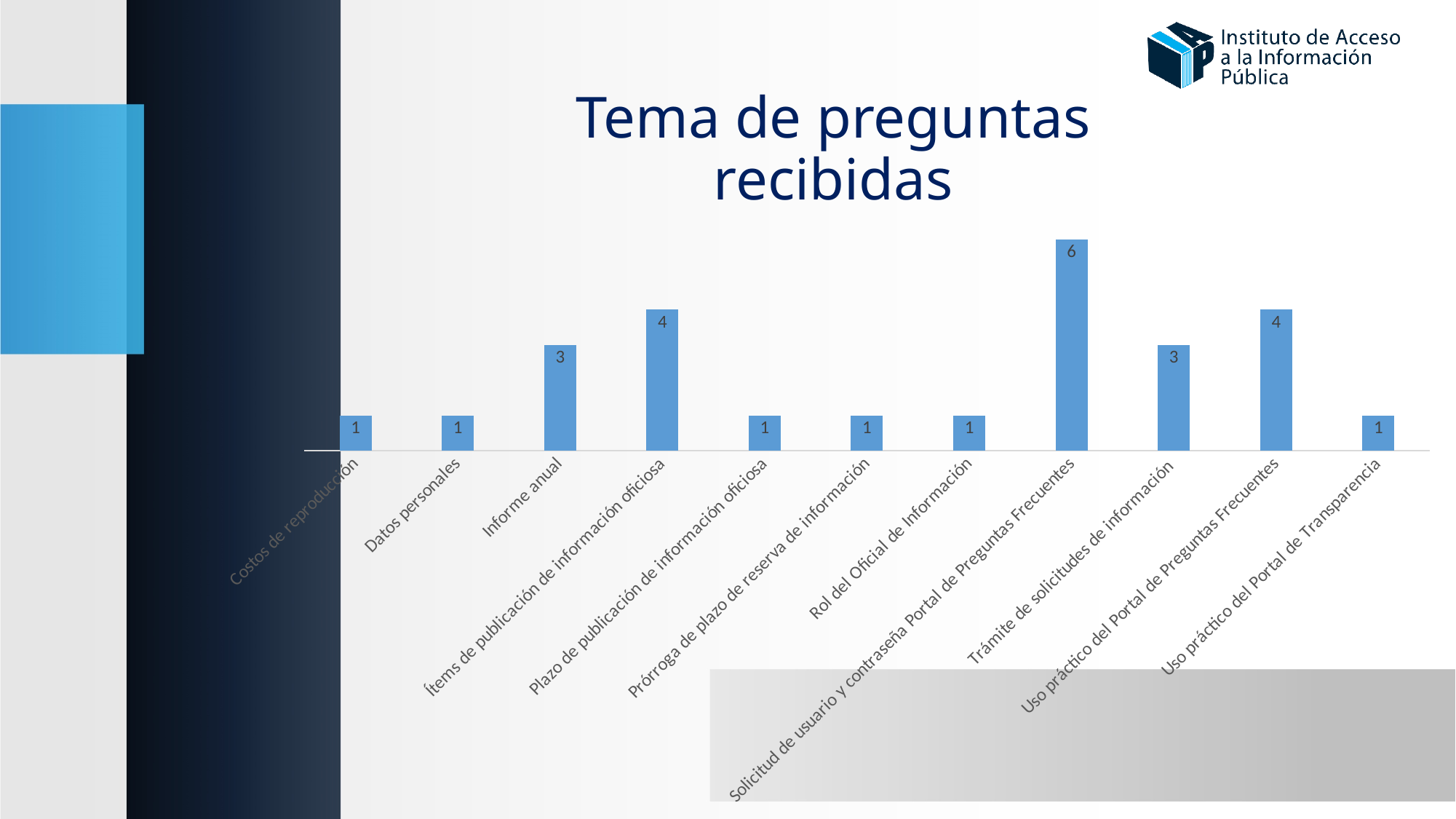
What is the value for Solicitud de usuario y contraseña Portal de Preguntas Frecuentes? 6 Which is larger, the value for Informe anual or the value for Ítems de publicación de información oficiosa? Ítems de publicación de información oficiosa What is the difference between the values for Uso práctico del Portal de Preguntas Frecuentes and Uso práctico del Portal de Transparencia? 3 What is the value for Rol del Oficial de Información? 1 What is the value for Informe anual? 3 What is the title of the chart? Tema de preguntas recibidas Which category has the highest value? Solicitud de usuario y contraseña Portal de Preguntas Frecuentes How many categories are shown in the chart? 11 What is the value for Trámite de solicitudes de información? 3 What kind of chart is shown on the slide? Bar chart What is the value for Uso práctico del Portal de Preguntas Frecuentes? 4 What is the difference between the values for Solicitud de usuario y contraseña Portal de Preguntas Frecuentes and Ítems de publicación de información oficiosa? 2